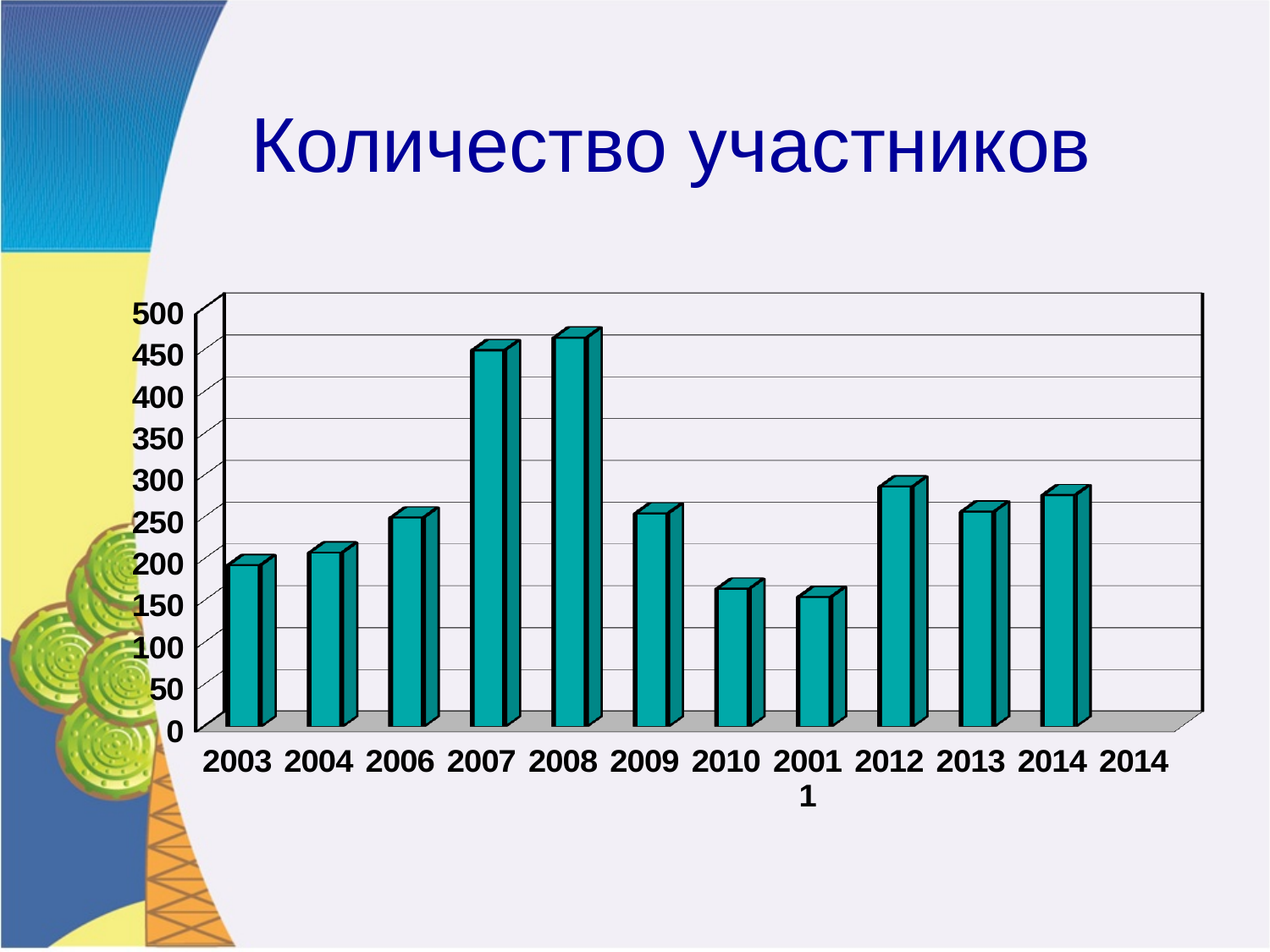
What kind of chart is shown on the slide? bar chart Which has the larger value, 2012 or 2010? 2012 Is the value for 2003 greater or less than 250? less Which has the larger value, 2006 or 2008? 2008 Which has the larger value, 2007 or 2003? 2007 Is the value for 2010 greater or less than 200? less Is the value for 2008 greater or less than 400? greater What is the title of the chart? Количество участников How many bars are plotted in the chart? 11